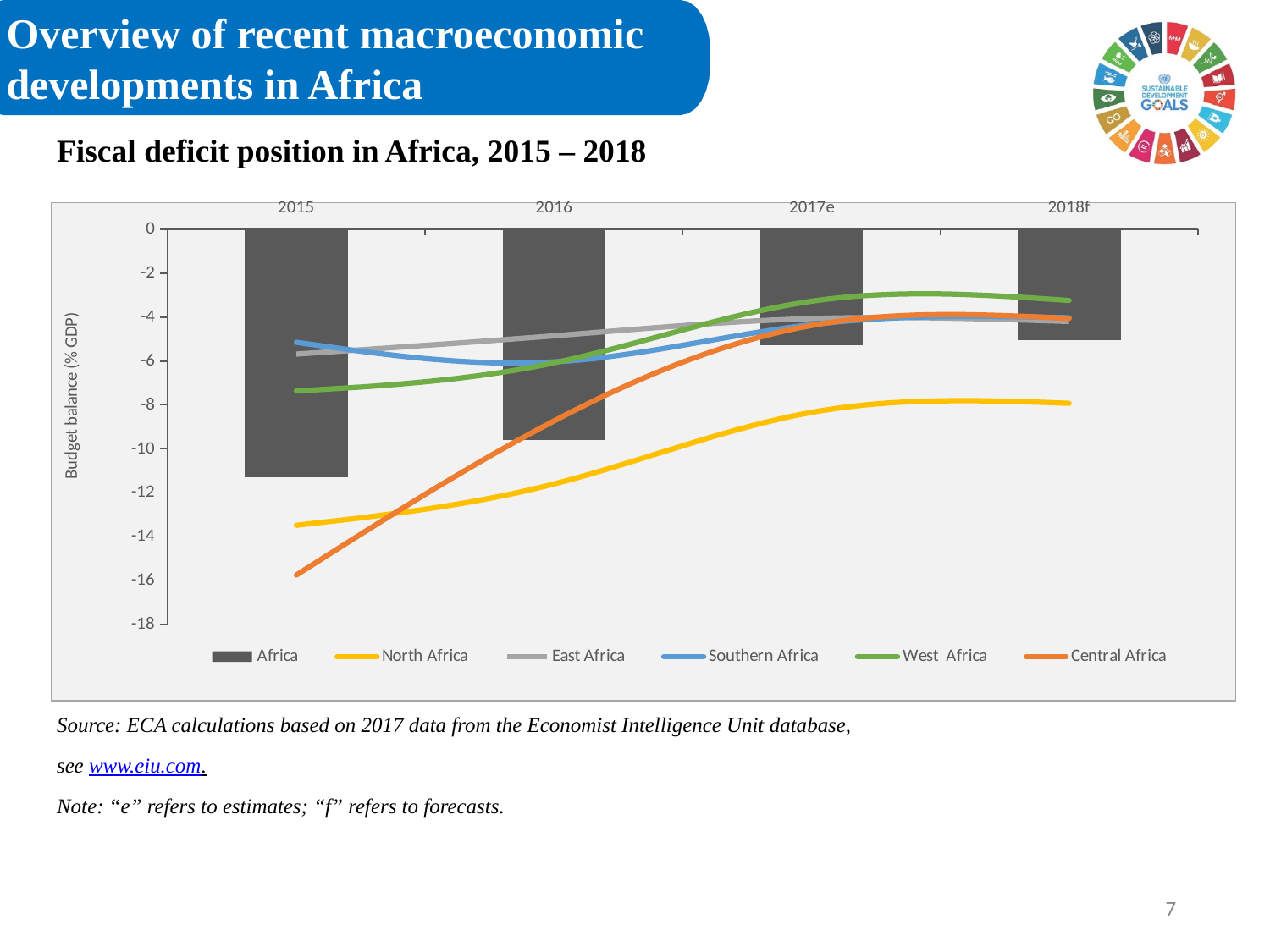
Which series has the lowest (most negative) value in 2015? Central Africa Do the Africa bar values rise or fall from 2015 to 2018f? rise Is the Africa bar value for 2015 greater or less than -10? less Which series is plotted as bars rather than a line? Africa Which series has the lowest (most negative) value in 2018f? North Africa How many time periods are shown on the x axis of the chart? 4 How many series does the chart legend list? 6 Is the Central Africa value for 2015 greater or less than -14? less What kind of chart is shown on the slide? Combined bar and line chart Is the West Africa value for 2017e greater or less than -4? greater What is the label of the vertical axis? Budget balance (% GDP)